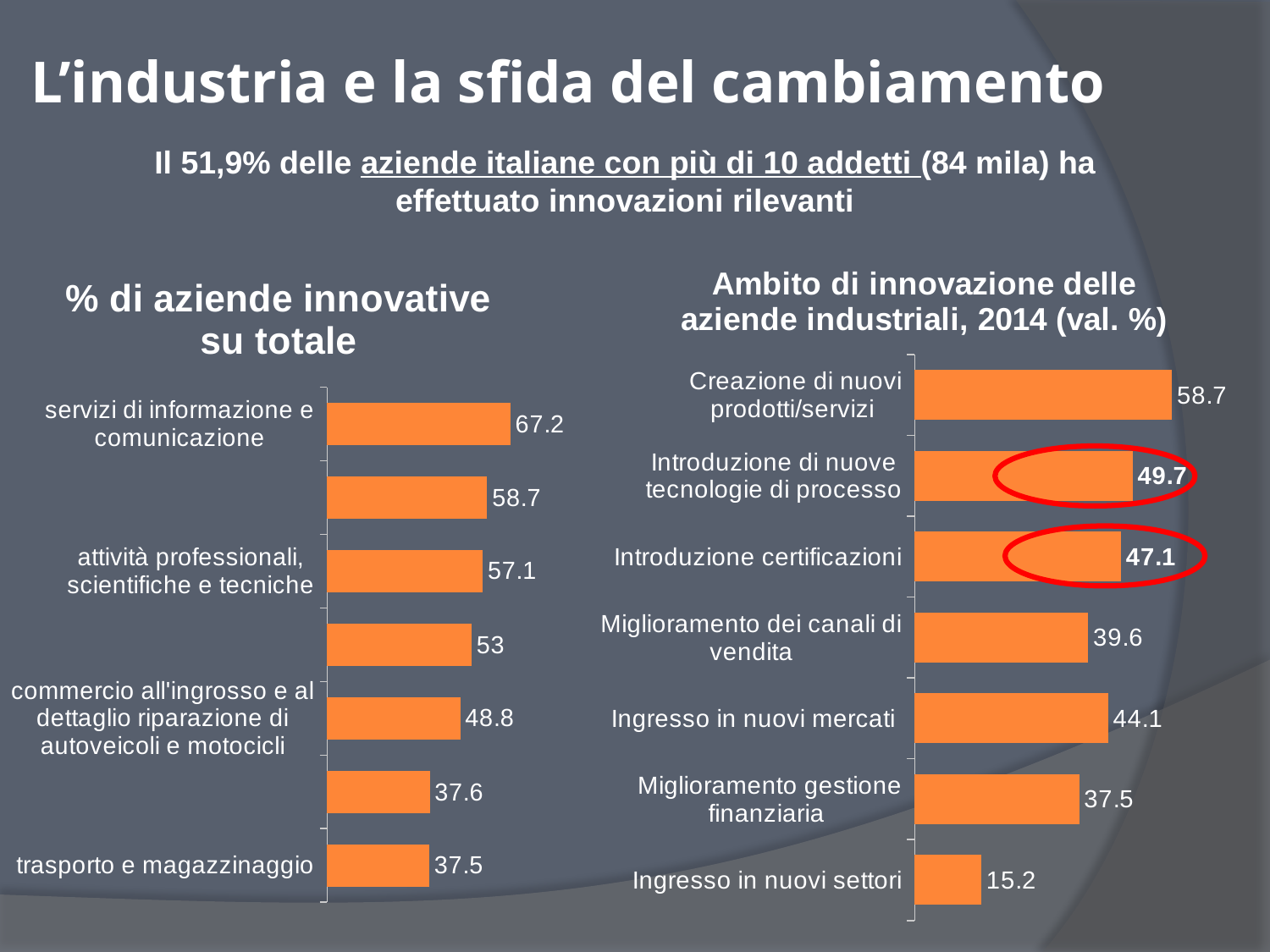
In the chart 'Ambito di innovazione delle aziende industriali, 2014 (val. %)', which category has the lowest value? Ingresso in nuovi settori What type of chart is '% di aziende innovative su totale'? Bar chart In the chart '% di aziende innovative su totale', what is the value for 'trasporto e magazzinaggio'? 37.5 How many bars are shown in the chart 'Ambito di innovazione delle aziende industriali, 2014 (val. %)'? 7 In the chart '% di aziende innovative su totale', what is the value for 'servizi di informazione e comunicazione'? 67.2 In the chart 'Ambito di innovazione delle aziende industriali, 2014 (val. %)', which two values are circled in red? 49.7 and 47.1 In the chart 'Ambito di innovazione delle aziende industriali, 2014 (val. %)', which category has the highest value? Creazione di nuovi prodotti/servizi In the chart 'Ambito di innovazione delle aziende industriali, 2014 (val. %)', what is the difference between 'Introduzione di nuove tecnologie di processo' and 'Introduzione certificazioni'? 2.6 In the chart 'Ambito di innovazione delle aziende industriali, 2014 (val. %)', what is the value for 'Creazione di nuovi prodotti/servizi'? 58.7 In the chart 'Ambito di innovazione delle aziende industriali, 2014 (val. %)', which is larger: 'Ingresso in nuovi mercati' or 'Miglioramento dei canali di vendita'? Ingresso in nuovi mercati In the chart 'Ambito di innovazione delle aziende industriali, 2014 (val. %)', what is the value for 'Ingresso in nuovi settori'? 15.2 In the chart '% di aziende innovative su totale', what is the difference between 'servizi di informazione e comunicazione' and 'attività professionali, scientifiche e tecniche'? 10.1